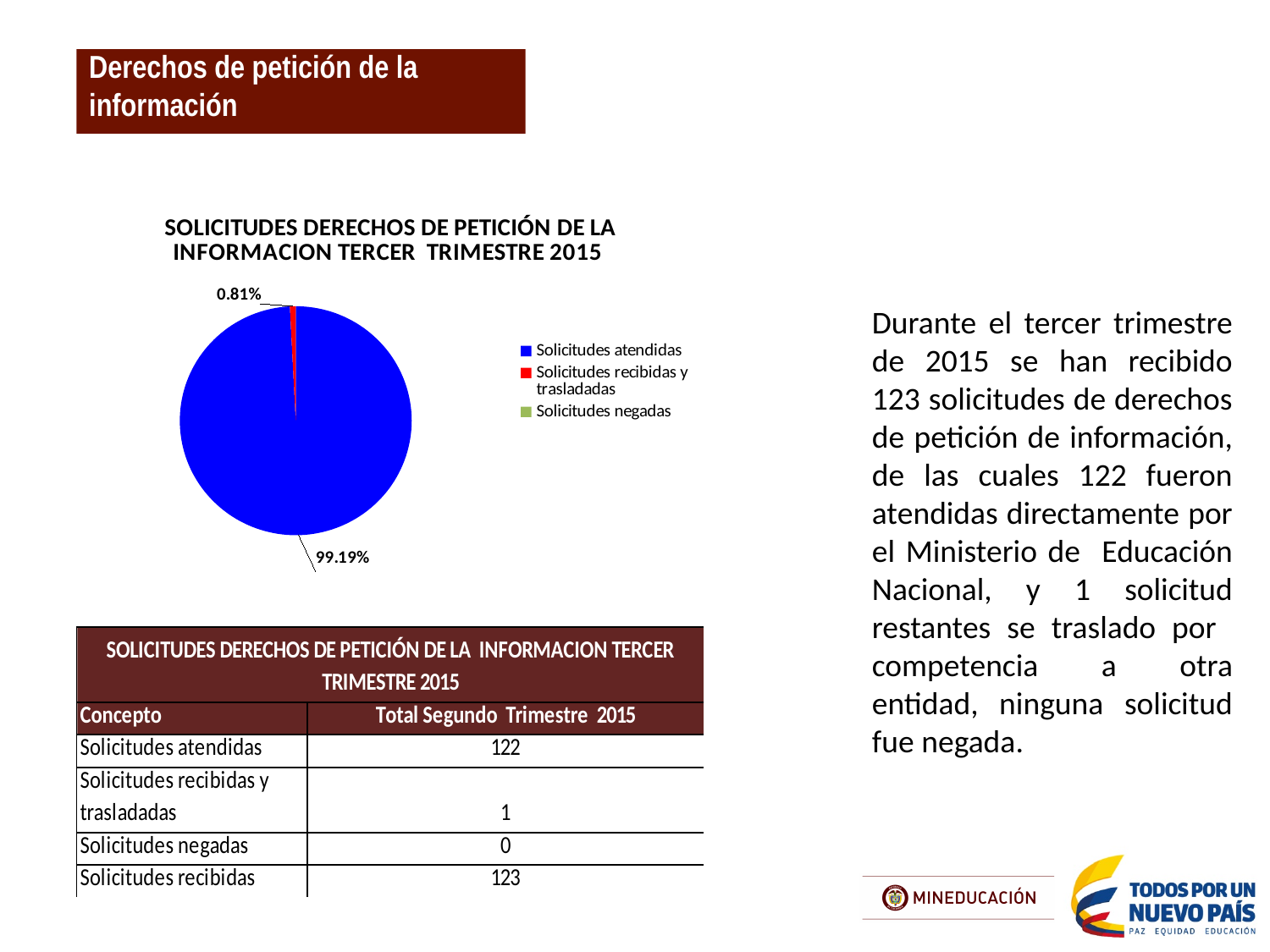
Which category has the largest slice of the pie? Solicitudes atendidas How many entries does the chart's legend list? 3 What kind of chart is shown on the slide? pie chart Which legend entry has no visible slice in the pie? Solicitudes negadas What percentage is shown for the Solicitudes recibidas y trasladadas slice? 0.81% Which of the two labelled slices is larger, Solicitudes atendidas or Solicitudes recibidas y trasladadas? Solicitudes atendidas What is the difference in percentage points between the Solicitudes atendidas slice and the Solicitudes recibidas y trasladadas slice? 98.38 What colour is the Solicitudes atendidas slice? blue Is the share for Solicitudes atendidas greater or less than 50%? greater What is the chart's title? SOLICITUDES DERECHOS DE PETICIÓN DE LA INFORMACION TERCER TRIMESTRE 2015 What percentage is shown for the Solicitudes atendidas slice? 99.19%